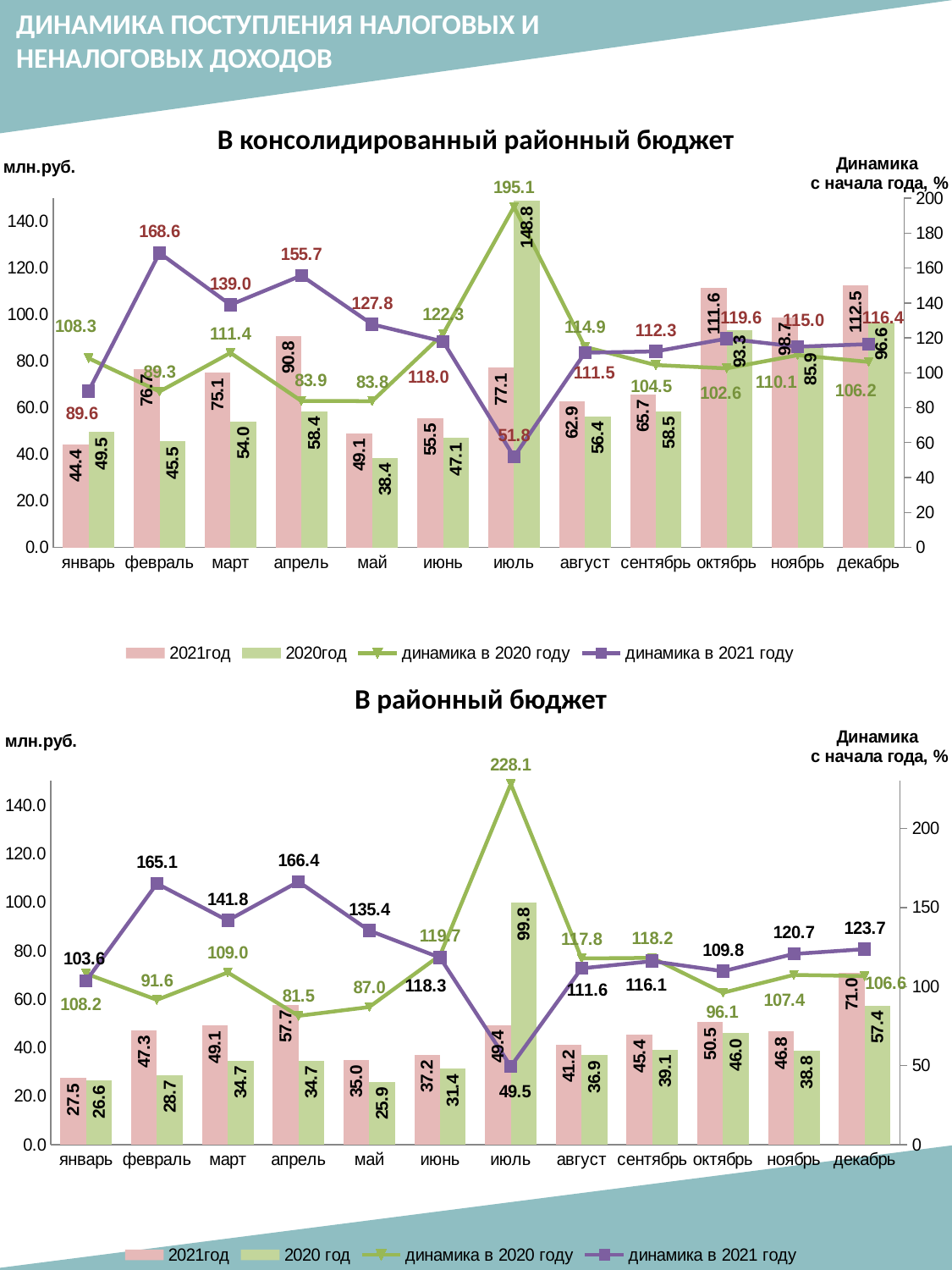
In the chart 'В районный бюджет', how many months are shown on the x axis? 12 In the chart 'В районный бюджет', which is larger for июль: the 2021год bar or the 2020год bar? 2020год In the chart 'В консолидированный районный бюджет', how many series does the legend list? 4 In the chart 'В консолидированный районный бюджет', what is the value of the 2021год bar for октябрь? 111.6 In the chart 'В консолидированный районный бюджет', what is the difference between the 2021год and 2020год bars for декабрь? 15.9 What kind of chart is 'В районный бюджет'? Combined bar and line chart In the chart 'В районный бюджет', which month has the lowest value on the 'динамика в 2021 году' line? июль In the chart 'В районный бюджет', what is the value of the 2021год bar for декабрь? 71.0 In the chart 'В консолидированный районный бюджет', what is the value of the 2020год bar for июль? 148.8 In the chart 'В консолидированный районный бюджет', which month has the lowest 2021год bar? январь In the chart 'В консолидированный районный бюджет', which month has the highest value on the 'динамика в 2021 году' line? февраль In the chart 'В районный бюджет', what is the value of the 'динамика в 2020 году' line for июль? 228.1